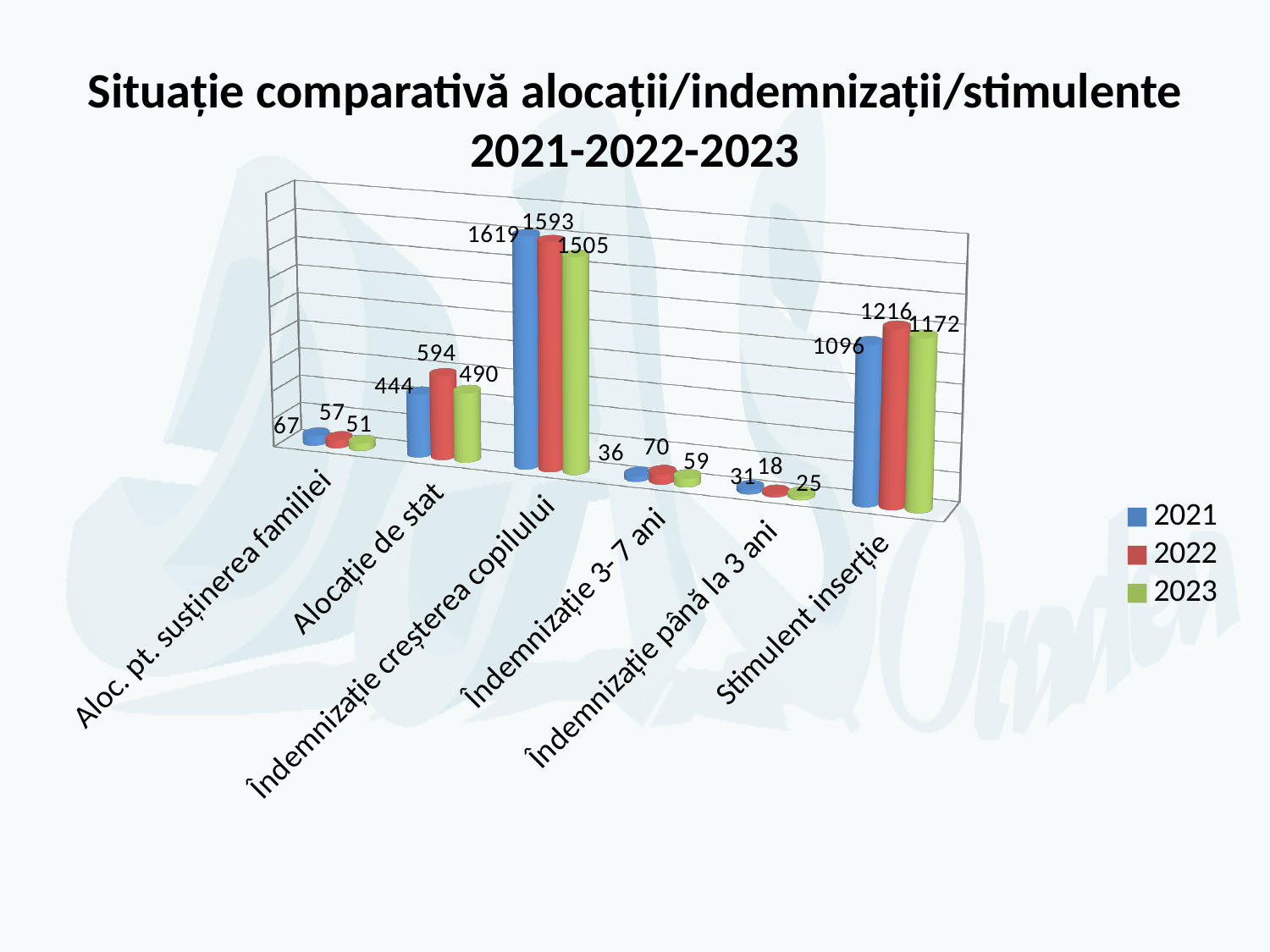
What is the difference between the 2021 and 2023 values for Îndemnizație creșterea copilului? 114 How many categories are shown on the x axis? 6 Which category has the highest value in 2021? Îndemnizație creșterea copilului Which category has the lowest value in 2022? Îndemnizație până la 3 ani What is the value for Stimulent inserție in 2021? 1096 What is the value for Alocație de stat in 2022? 594 What is the value for Îndemnizație până la 3 ani in 2023? 25 What is the difference between the 2022 and 2021 values for Stimulent inserție? 120 How many series does the legend list? 3 Do the values for Aloc. pt. susținerea familiei rise or fall from 2021 to 2023? Fall What kind of chart is shown on the slide? Bar chart Which is larger for Îndemnizație 3-7 ani: the 2022 value or the 2023 value? 2022